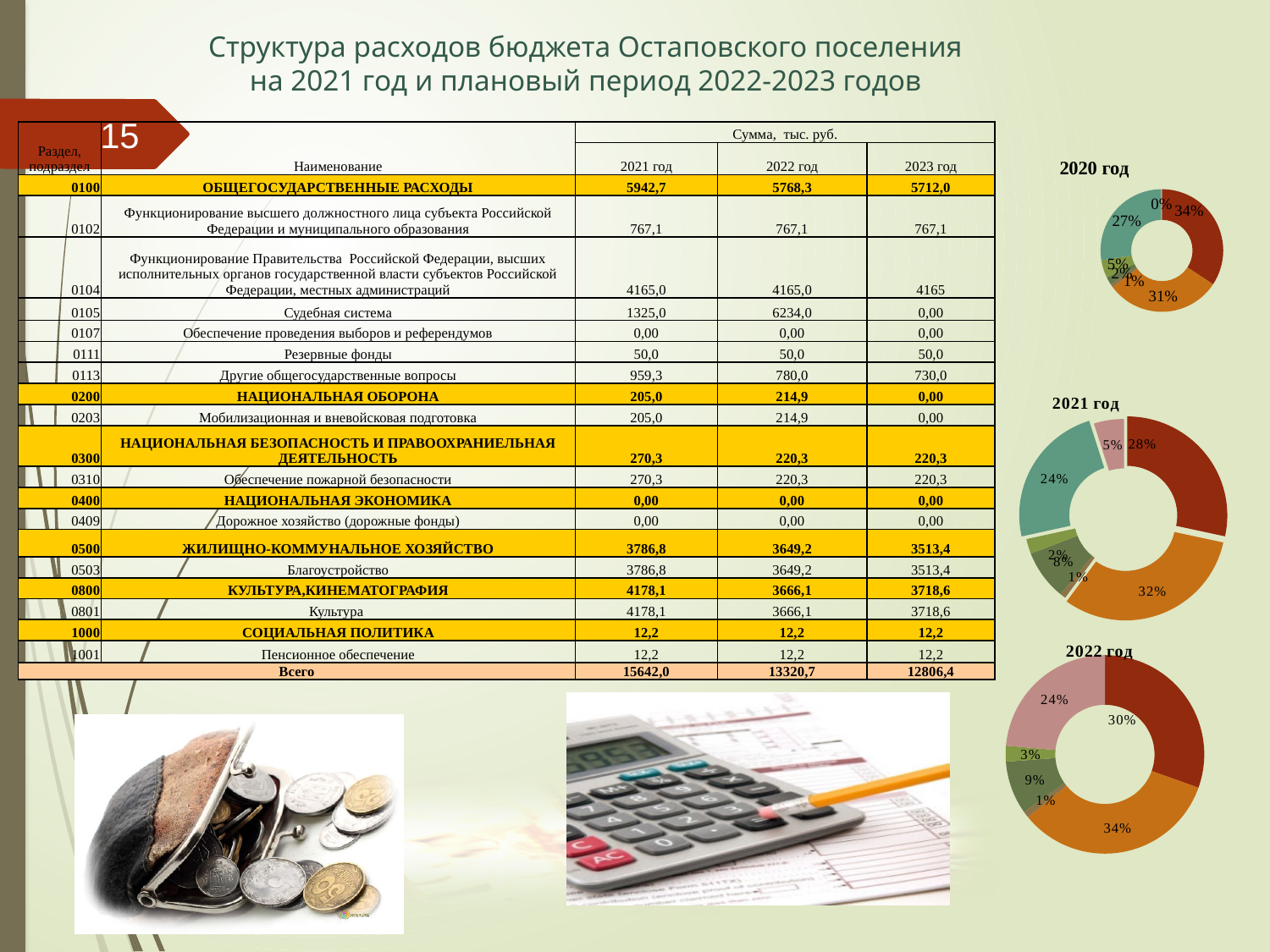
In the chart titled "2020 год", what is the largest share shown? 34% In the chart titled "2020 год", what share is shown for the orange slice at the bottom? 31% In the chart titled "2021 год", what share is shown for the teal slice on the left? 24% In the chart titled "2022 год", how many slices are labelled? 6 In the chart titled "2021 год", what is the largest share shown? 32% In the chart titled "2022 год", what is the smallest share shown? 1% In the chart titled "2022 год", what share is shown for the pink slice on the upper left? 24% What kind of chart is the chart titled "2022 год"? doughnut chart In the chart titled "2022 год", what is the difference in percentage points between the 34% slice and the 30% slice? 4 In the chart titled "2021 год", which is larger: the red slice at 28% or the orange slice at 32%? the orange slice at 32% How many doughnut charts are on the slide? 3 In the chart titled "2022 год", what is the largest share shown? 34%